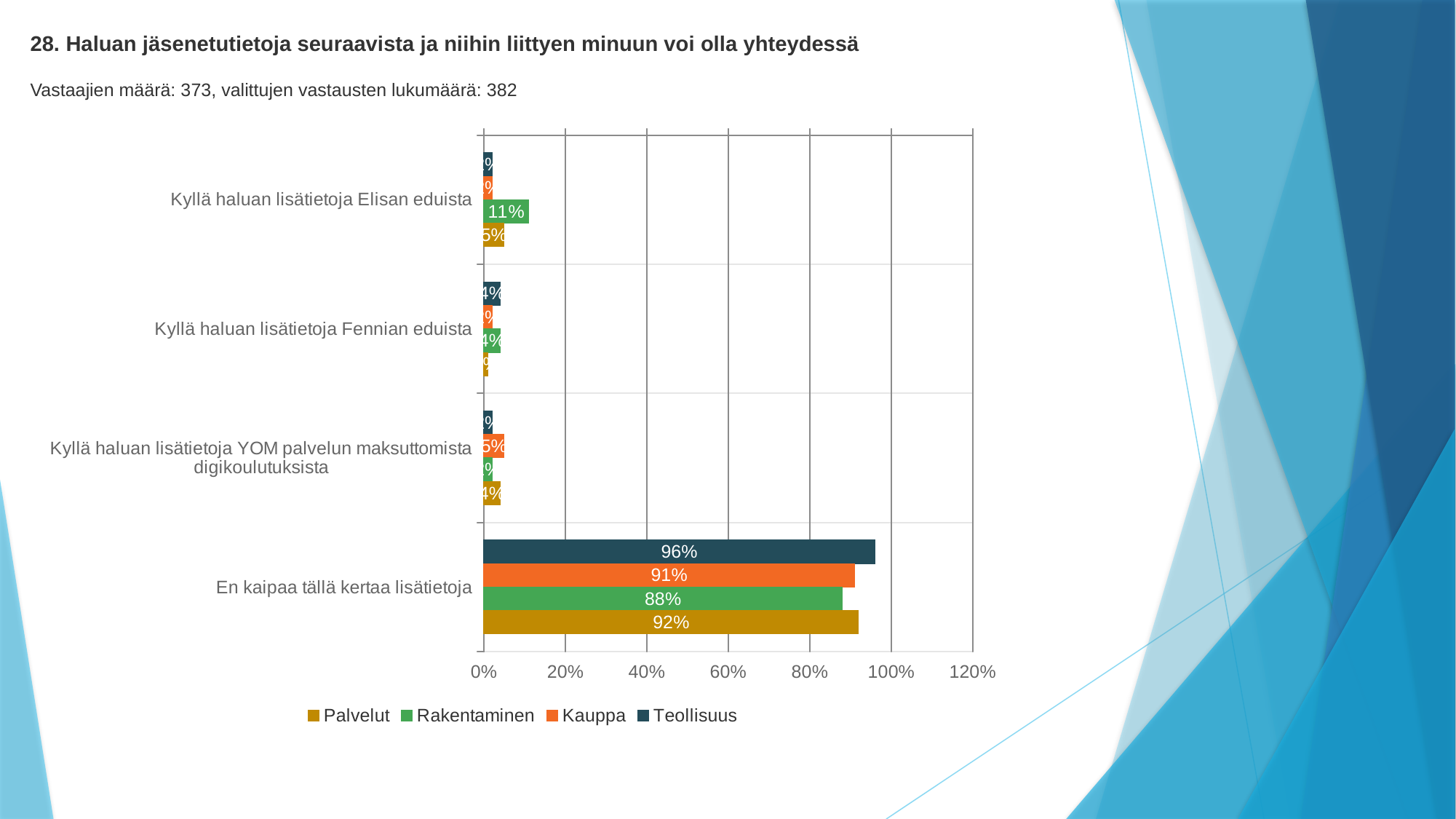
Which series has the highest value in the category 'En kaipaa tällä kertaa lisätietoja'? Teollisuus What is the value for Teollisuus in the category 'En kaipaa tällä kertaa lisätietoja'? 96% What is the value for Palvelut in the category 'En kaipaa tällä kertaa lisätietoja'? 92% Which series has the lowest value in the category 'En kaipaa tällä kertaa lisätietoja'? Rakentaminen How many series does the legend list? 4 What is the value for Rakentaminen in the category 'Kyllä haluan lisätietoja Elisan eduista'? 11% Is the value for Rakentaminen in 'Kyllä haluan lisätietoja Elisan eduista' greater or less than 20%? less What is the value for Rakentaminen in the category 'En kaipaa tällä kertaa lisätietoja'? 88% How many categories are shown on the chart? 4 What is the value for Kauppa in the category 'En kaipaa tällä kertaa lisätietoja'? 91% What kind of chart is shown on the slide? bar chart What is the difference between the Teollisuus and Rakentaminen values in the category 'En kaipaa tällä kertaa lisätietoja'? 8%